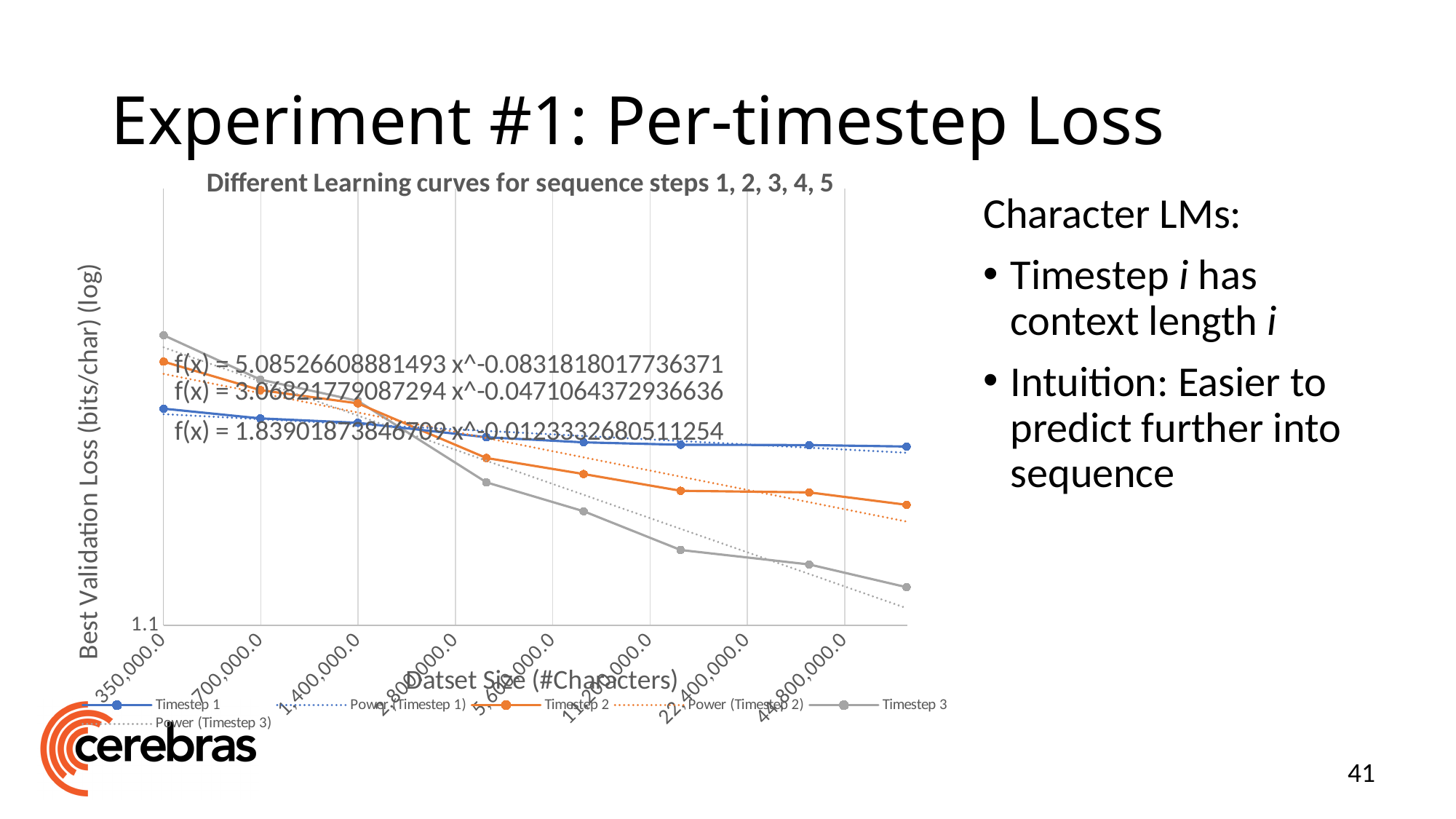
How many entries does the chart legend list? 6 At 350,000.0 characters, which is larger: the value for Timestep 2 or the value for Timestep 1? Timestep 2 Is the value for Timestep 3 at the rightmost data point greater or less than 1.1? greater How many dataset-size labels are shown on the x axis? 8 Does the Timestep 3 series rise or fall as dataset size increases along the x axis? fall At the leftmost point (350,000.0), which series has the highest validation loss? Timestep 3 At the rightmost data point, which series has the lowest validation loss? Timestep 3 What is the x-axis title of the chart? Datset Size (#Characters) What kind of chart is shown on the slide? line chart At the rightmost data point, which is larger: the value for Timestep 1 or the value for Timestep 3? Timestep 1 Does the Timestep 1 series rise or fall as dataset size increases along the x axis? fall What is the title of the chart? Different Learning curves for sequence steps 1, 2, 3, 4, 5